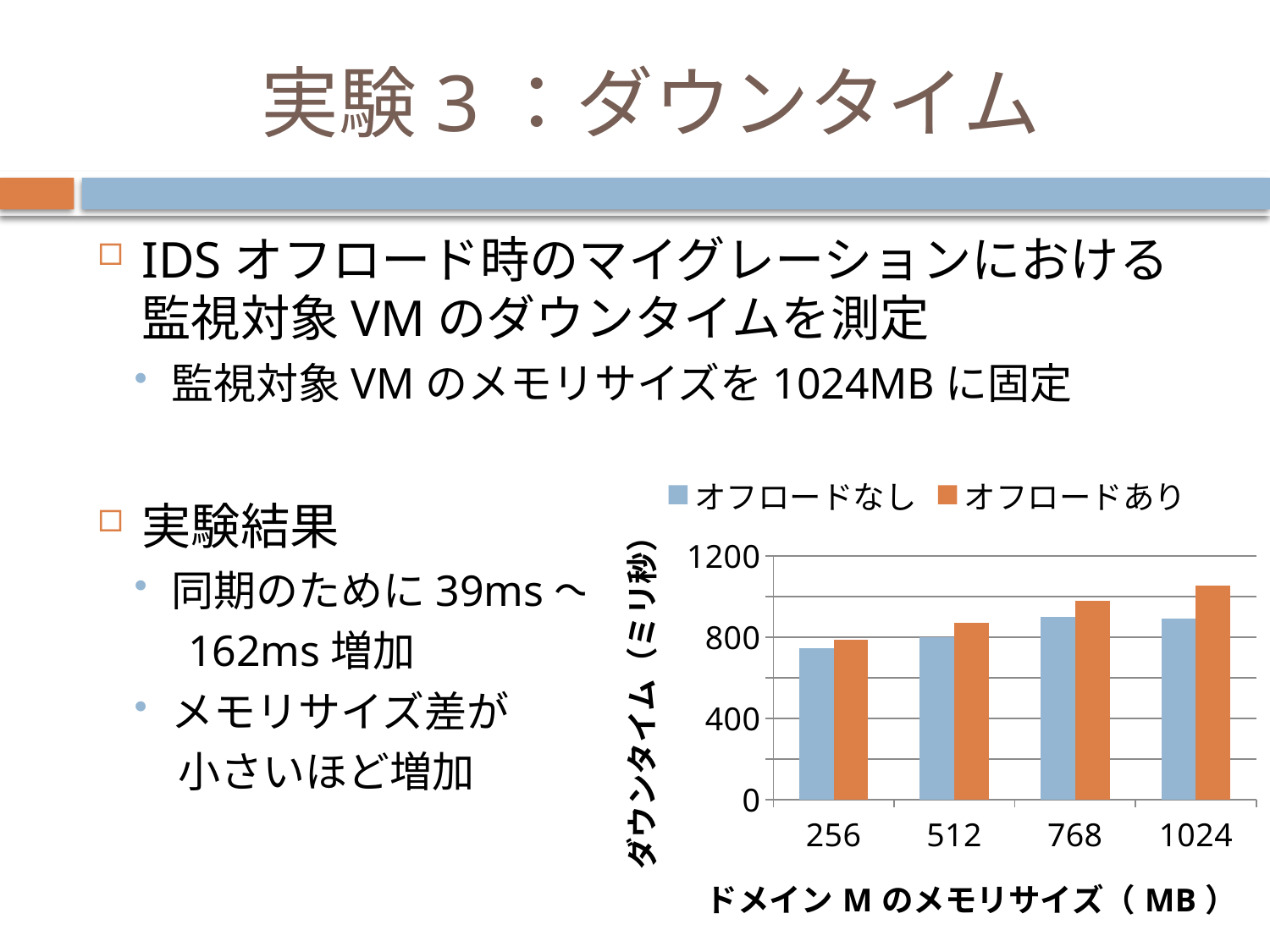
Is the value for オフロードあり at 1024 MB greater or less than 800? greater At 1024 MB, which series has the larger value, オフロードなし or オフロードあり? オフロードあり Which memory size has the highest value for the オフロードあり series? 1024 Is the value for オフロードなし at 256 MB greater or less than 800? less Is the value for オフロードあり at 768 MB greater or less than 1200? less Which memory size has the lowest value for the オフロードなし series? 256 How many memory-size categories are shown on the x axis of the chart? 4 What kind of chart is shown on the slide? bar chart What is the title of the chart's y axis? ダウンタイム（ミリ秒） How many series does the chart legend list? 2 Do the values for the オフロードあり series rise or fall as the memory size increases along the x axis? rise Which colour represents the オフロードあり series in the chart? orange